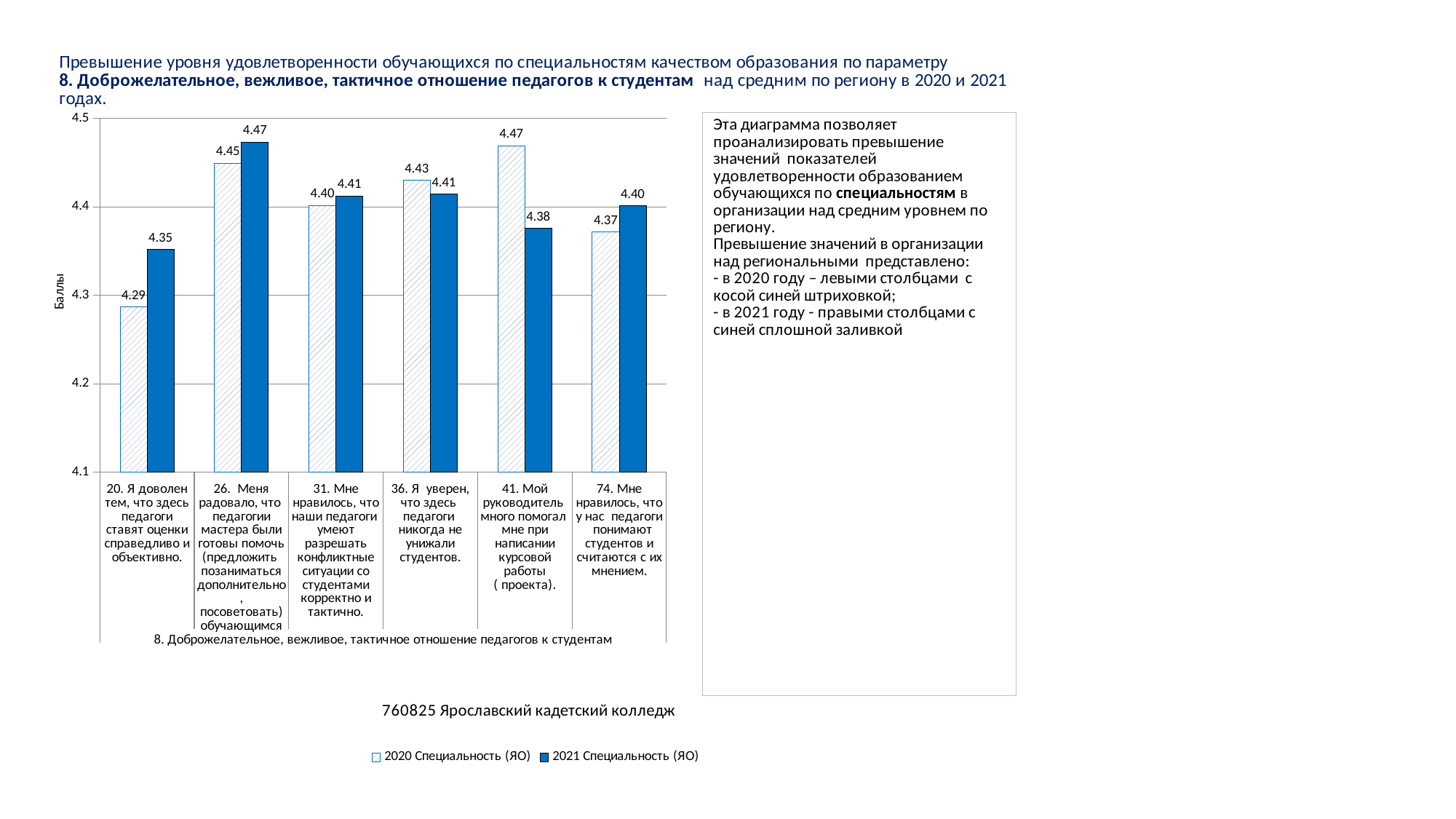
What is the difference between the 2020 and 2021 values for category 41 (Мой руководитель много помогал мне при написании курсовой работы)? 0.09 What is the label of the y axis of the chart? Баллы Which category has the highest 2021 Специальность (ЯО) value? 26. Меня радовало, что педагоги мастера были готовы помочь What type of chart is shown on the slide? bar chart How many categories (questions) are shown on the x axis of the chart? 6 What is the 2021 Специальность (ЯО) value for category 41 (Мой руководитель много помогал мне при написании курсовой работы)? 4.38 For category 36 (Я уверен, что здесь педагоги никогда не унижали студентов), which is larger: the 2020 or the 2021 value? 2020 What is the 2020 Специальность (ЯО) value for category 20 (Я доволен тем, что здесь педагоги ставят оценки справедливо и объективно)? 4.29 Which category has the lowest 2020 Специальность (ЯО) value? 20. Я доволен тем, что здесь педагоги ставят оценки справедливо и объективно How many series does the chart legend list? 2 What is the 2021 Специальность (ЯО) value for category 74 (Мне нравилось, что у нас педагоги понимают студентов и считаются с их мнением)? 4.40 Is the 2020 Специальность (ЯО) value for category 20 greater or less than 4.3? less